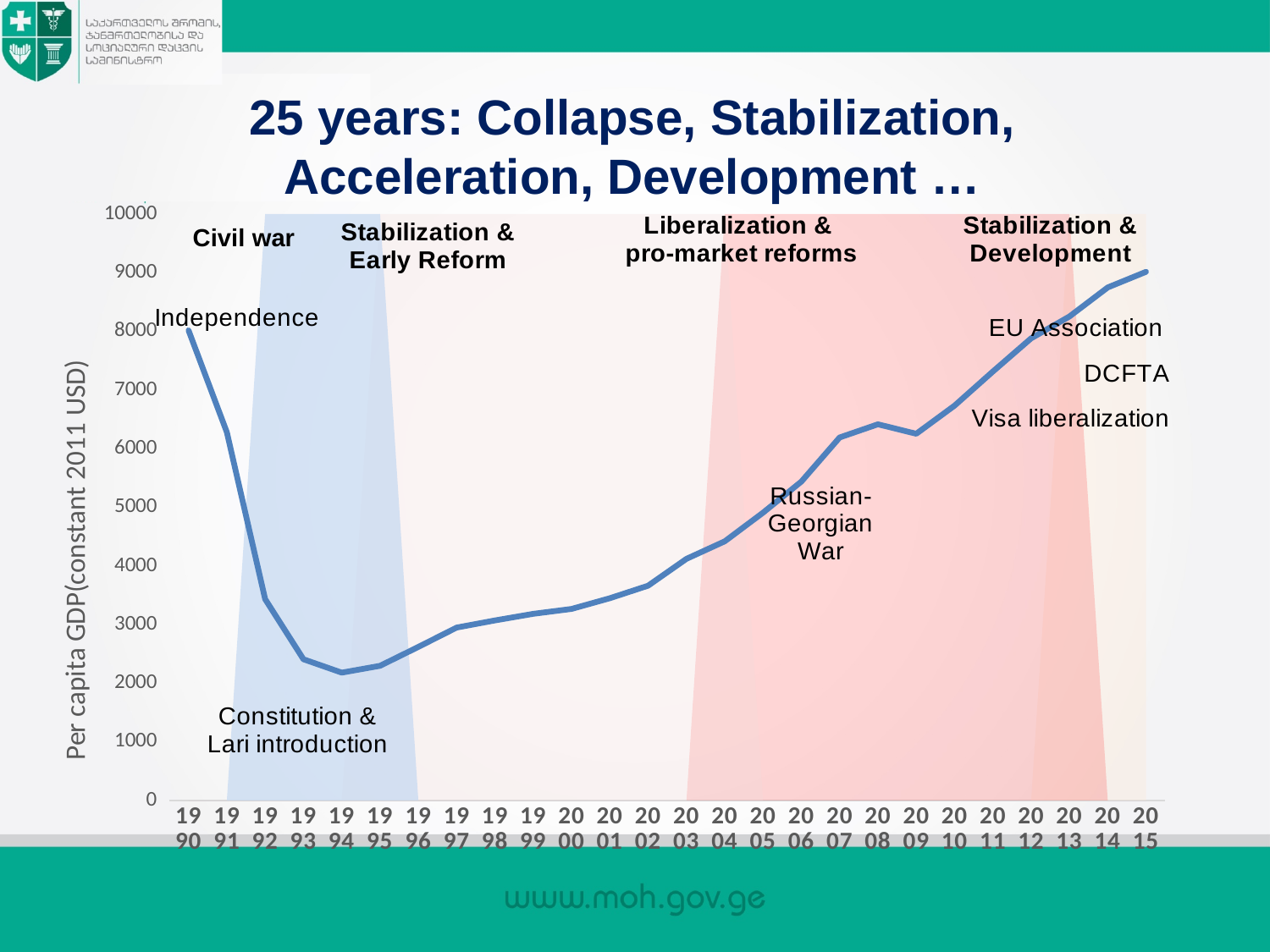
Is the value for 1994 greater or less than 3000? less Is the value for 2015 greater or less than 8000? greater What kind of chart is shown on the slide? line chart In which year is per capita GDP highest? 2015 Which year has the higher per capita GDP, 1990 or 2015? 2015 Is the value for 1990 greater or less than 7000? greater In which year is per capita GDP lowest? 1994 What is the title of the slide's chart? 25 years: Collapse, Stabilization, Acceleration, Development … Does per capita GDP rise or fall from 1990 to 1994? fall What is the label of the vertical axis? Per capita GDP(constant 2011 USD) How many years are plotted along the x axis? 26